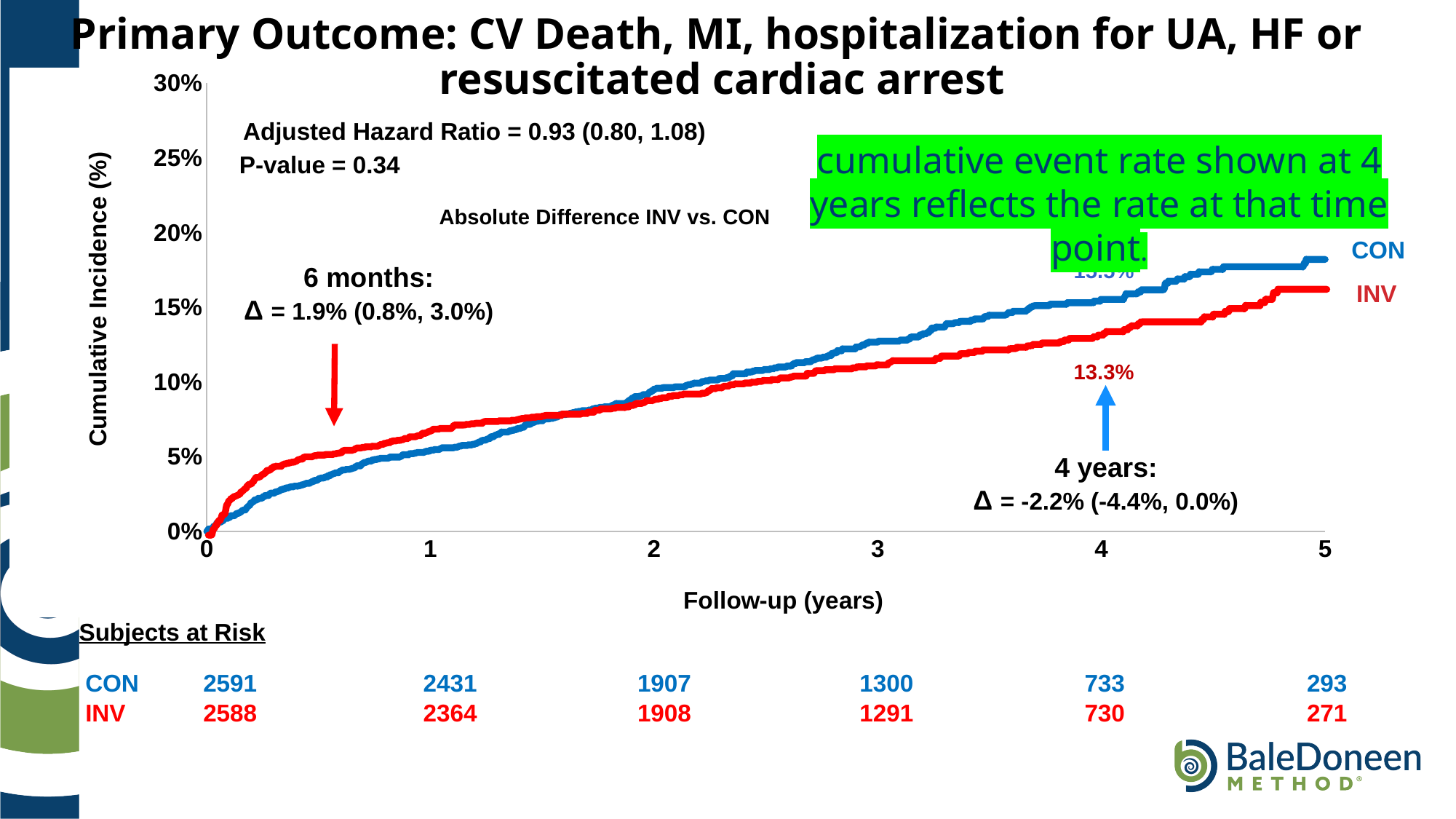
Is the cumulative incidence for CON at 5 years greater or less than 15%? greater At 6 months of follow-up, which curve is higher, CON or INV? INV What is the adjusted hazard ratio printed on the chart? 0.93 (0.80, 1.08) Do the cumulative incidence curves rise or fall as follow-up time increases? rise At 4 years of follow-up, which curve is higher, CON or INV? CON What kind of chart is shown on the slide? line chart Is the cumulative incidence for INV at 2 years greater or less than 10%? less What is the absolute difference INV vs. CON shown at 4 years? Δ = -2.2% (-4.4%, 0.0%) How many CON subjects are at risk at 4 years according to the Subjects at Risk table? 733 What is the cumulative incidence labelled for the INV group at 4 years? 13.3% How many series (groups) are plotted on the chart? 2 What is the absolute difference INV vs. CON shown at 6 months? Δ = 1.9% (0.8%, 3.0%)